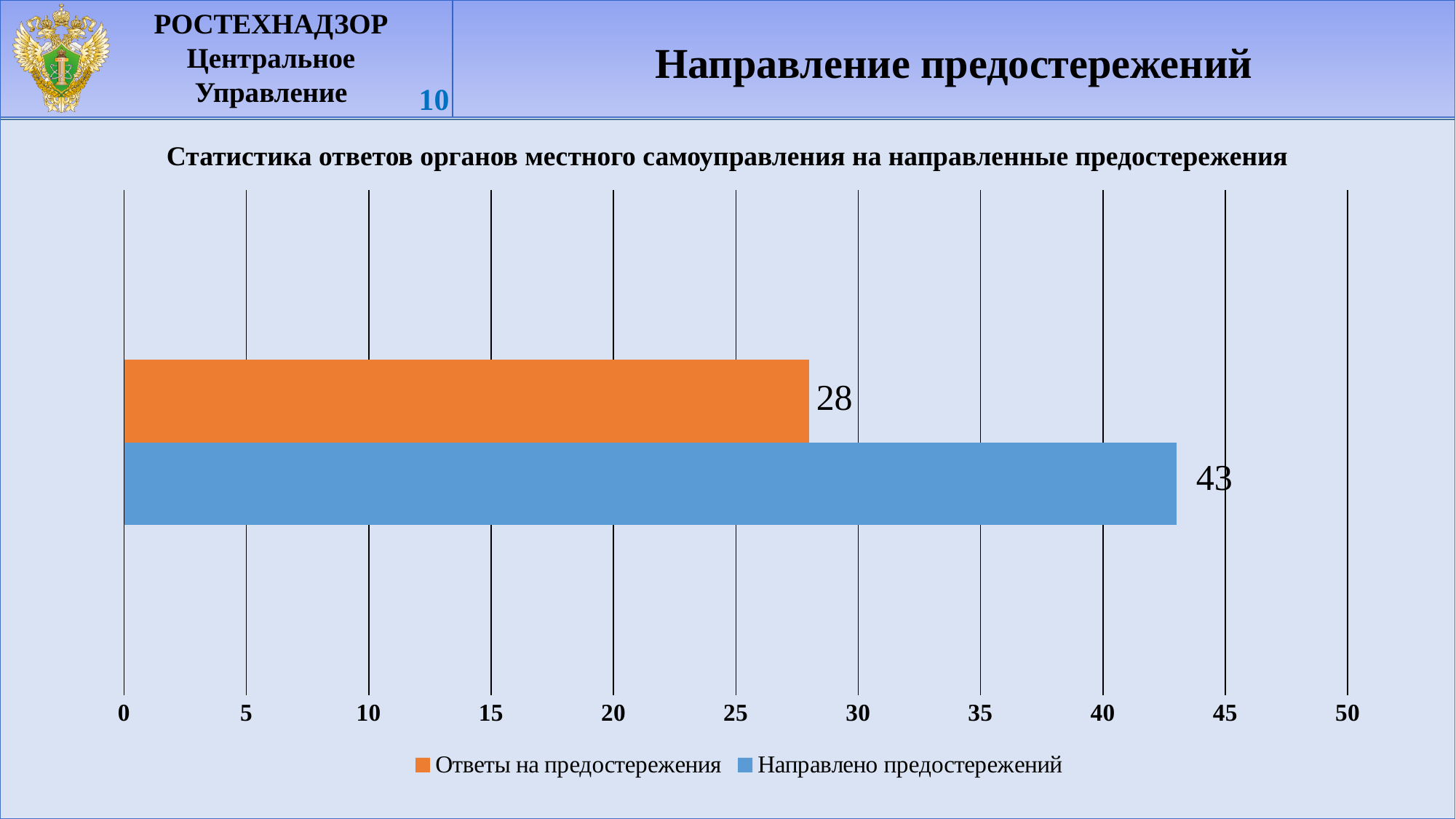
What is the difference between the value for "Направлено предостережений" and the value for "Ответы на предостережения"? 15 Which series has the highest value? Направлено предостережений Is the value for "Направлено предостережений" greater or less than 40? greater Is the value for "Ответы на предостережения" greater or less than 30? less Which series has the higher value, "Ответы на предостережения" or "Направлено предостережений"? Направлено предостережений Which series has the lowest value? Ответы на предостережения What is the value for "Направлено предостережений"? 43 What is the title of the chart? Статистика ответов органов местного самоуправления на направленные предостережения What kind of chart is shown on the slide? Bar chart How many series does the legend list? 2 What colour is the bar for "Направлено предостережений"? Blue What is the value for "Ответы на предостережения"? 28